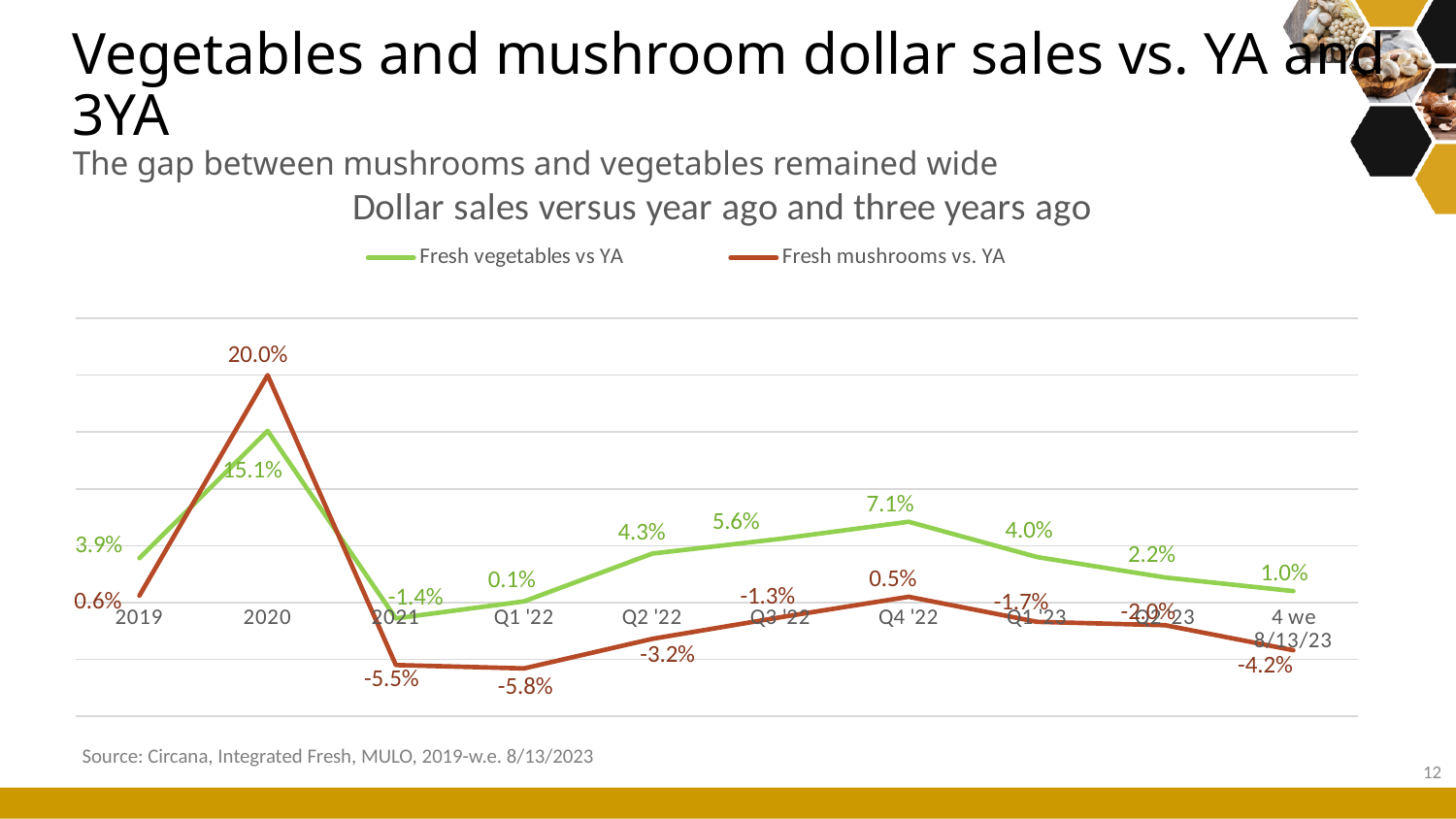
In 2020, how much higher is the Fresh mushrooms vs. YA value than the Fresh vegetables vs YA value? 4.9 percentage points What kind of chart is shown on the slide? Line chart What is the title of the chart? Dollar sales versus year ago and three years ago In which period is the Fresh mushrooms vs. YA value lowest? Q1 '22 What is the value for Fresh vegetables vs YA in Q4 '22? 7.1% How many series does the legend list? 2 From Q4 '22 to 4 we 8/13/23, do the Fresh vegetables vs YA values rise or fall? Fall In Q3 '22, which series has the larger value, Fresh vegetables vs YA or Fresh mushrooms vs. YA? Fresh vegetables vs YA What is the value for Fresh mushrooms vs. YA for the 4 we 8/13/23 period? -4.2% What is the value for Fresh mushrooms vs. YA in 2020? 20.0% How many time periods are plotted on the x axis? 10 In which period is the Fresh vegetables vs YA value highest? 2020